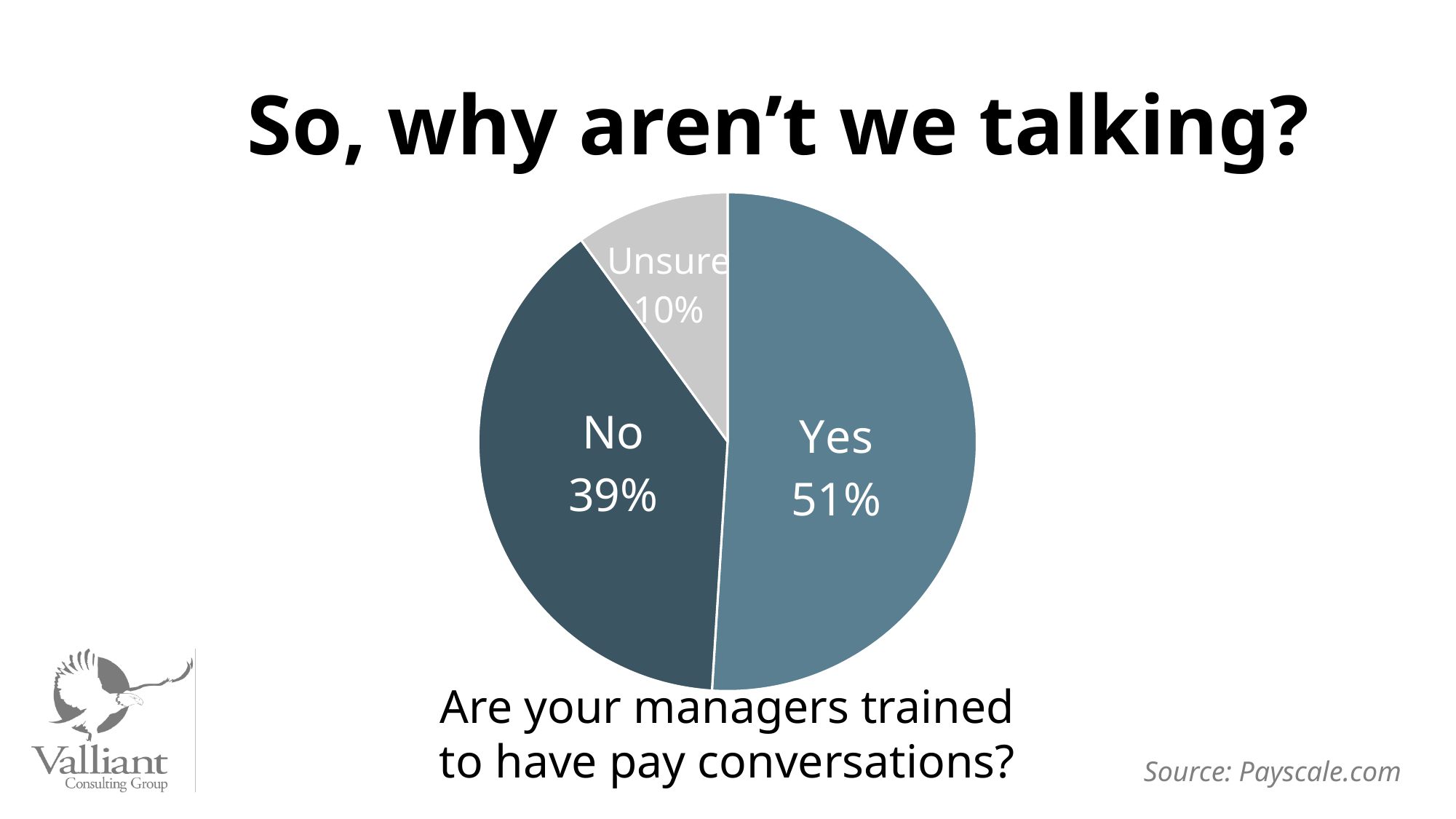
What percentage of respondents were Unsure? 10% Which is larger, the Yes slice or the No slice? Yes What is the source cited for the chart data? Payscale.com Which response has the largest share of the pie? Yes What is the difference in percentage points between the Yes and No slices? 12 What is the difference in percentage points between the No and Unsure slices? 29 What question does the pie chart answer, according to the caption below it? Are your managers trained to have pay conversations? Which response has the smallest share of the pie? Unsure What percentage of respondents answered Yes to whether their managers are trained to have pay conversations? 51% What percentage of respondents answered No? 39% What type of chart is shown on the slide? Pie chart How many slices does the pie chart have? 3